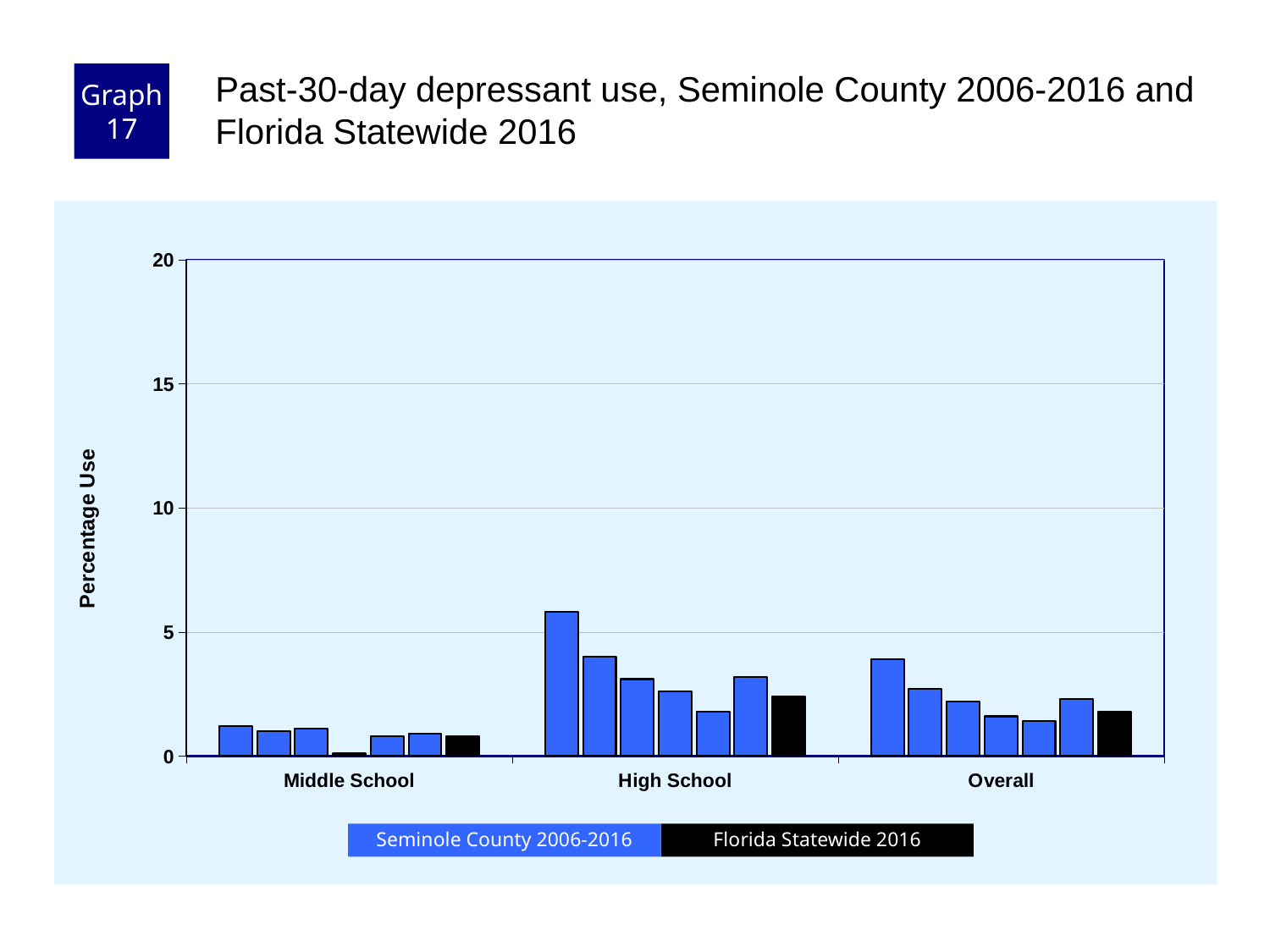
Is the value of the tallest Seminole County bar in the High School group greater or less than 5? greater Is the value of the Florida Statewide 2016 bar for Middle School greater or less than 5? less How many categories are shown along the x axis? 3 Which colour represents Florida Statewide 2016 in the legend? black How many series does the legend list? 2 How many bars are plotted in the High School group? 7 What kind of chart is shown on the slide? bar chart Which category group contains the tallest bar on the chart? High School Which is larger: the Florida Statewide 2016 bar for High School or the Florida Statewide 2016 bar for Middle School? High School What is the label on the y axis? Percentage Use Is the value of the tallest Seminole County bar in the Overall group greater or less than 5? less Across the first five Seminole County bars in the High School group, do the values rise or fall from left to right? fall